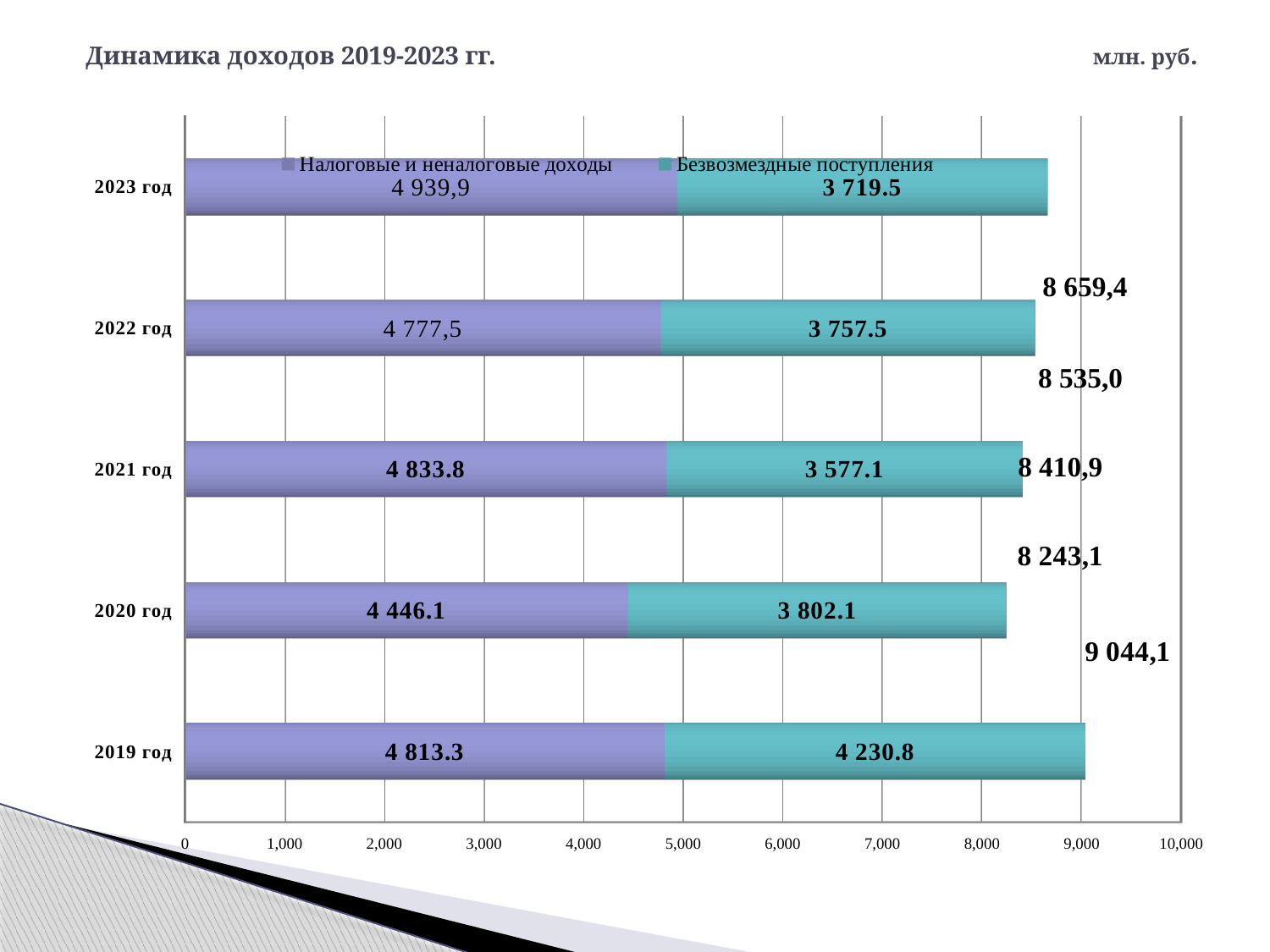
What is the difference between Налоговые и неналоговые доходы in 2019 год and in 2020 год? 367.2 Which year has the highest value for Безвозмездные поступления? 2019 год How many years are shown on the chart? 5 What kind of chart is shown on the slide? bar chart What is the value of Безвозмездные поступления for 2022 год? 3 757.5 How many series does the legend list? 2 Which year has the lowest value for Безвозмездные поступления? 2021 год Which is larger: Безвозмездные поступления in 2020 год or in 2022 год? 2020 год Which year has the highest value for Налоговые и неналоговые доходы? 2023 год Which year has the lowest value for Налоговые и неналоговые доходы? 2020 год What is the value of Налоговые и неналоговые доходы for 2021 год? 4 833.8 What is the value of Безвозмездные поступления for 2019 год? 4 230.8